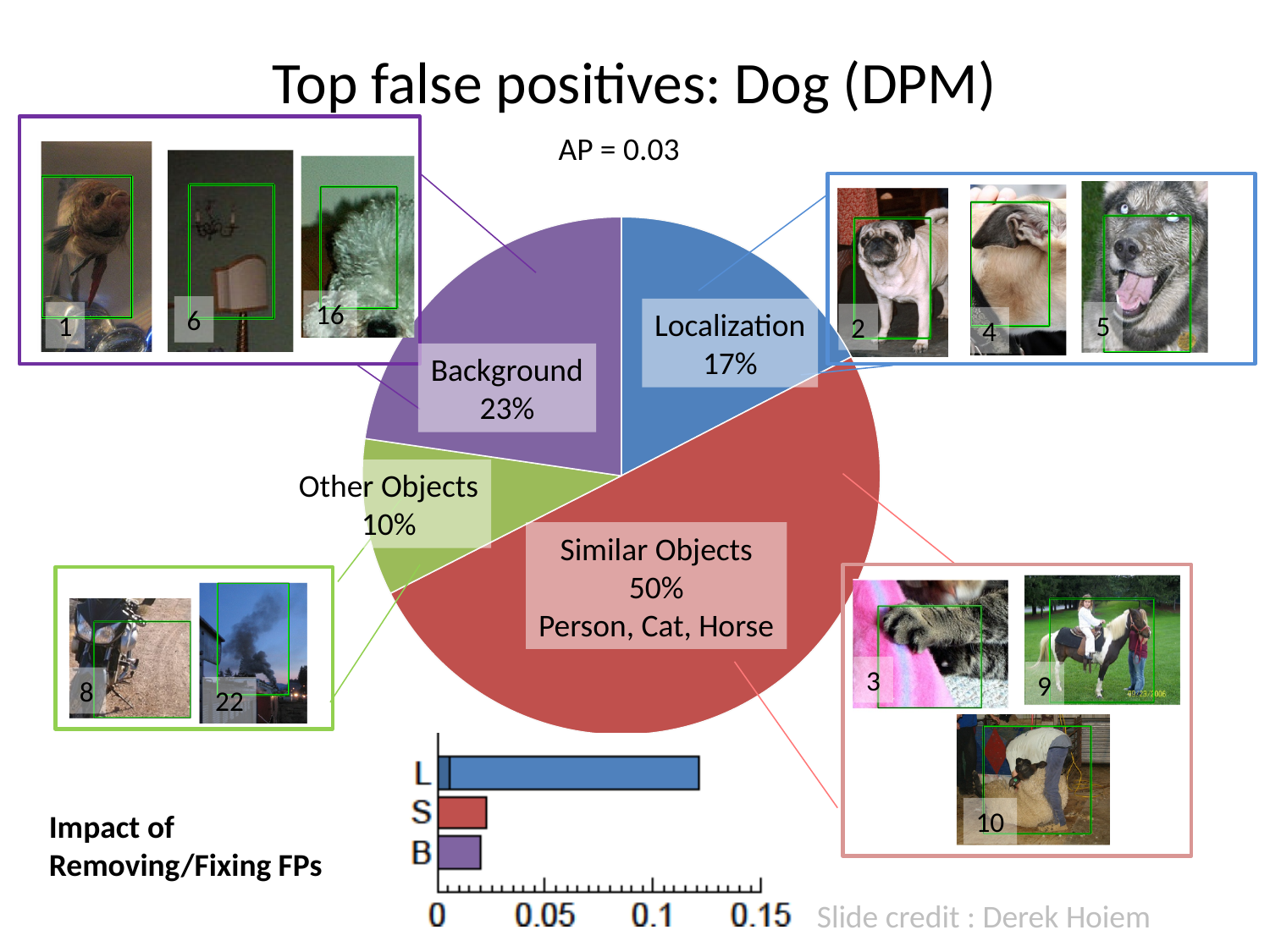
In the pie chart, which category has the smallest slice? Other Objects In the pie chart, what percentage is labelled for Background? 23% In the pie chart, what share of top false positives is attributed to Similar Objects? 50% What kind of chart is the 'Impact of Removing/Fixing FPs' chart at the bottom of the slide? bar chart In the pie chart, what percentage is labelled for Localization? 17% In the pie chart, which category has the largest slice? Similar Objects In the 'Impact of Removing/Fixing FPs' bar chart, is the value for L greater or less than 0.1? greater In the 'Impact of Removing/Fixing FPs' bar chart, which category has the longest bar? L In the pie chart, which is larger: the Localization slice or the Background slice? Background In the pie chart, how many percentage points larger is the Background slice than the Other Objects slice? 13 How many categories does the pie chart show? 4 In the pie chart, which example object classes are listed under the Similar Objects slice? Person, Cat, Horse